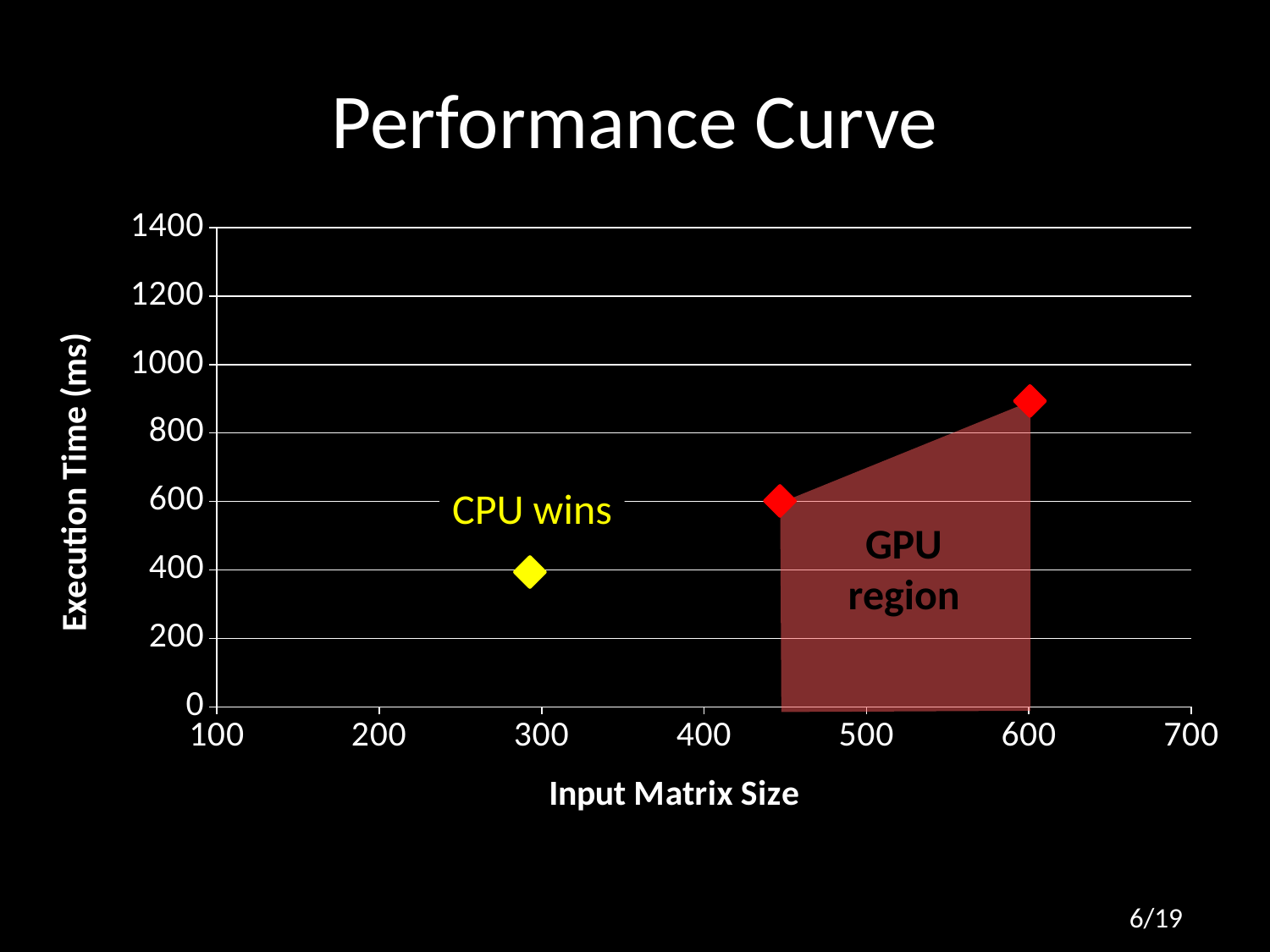
Is the execution time of the rightmost red point greater or less than 1000? less Which point has the highest execution time: the yellow point, the left red point, or the right red point? the right red point What is the title of the chart? Performance Curve Does execution time rise or fall as input matrix size increases along the x axis? rise How many data points are plotted on the chart? 3 Is the execution time of the yellow point larger or smaller than that of the left red point? smaller What is the label of the y axis? Execution Time (ms) Is the execution time of the yellow point greater or less than 200? greater Which point has the lowest execution time: the yellow point, the left red point, or the right red point? the yellow point Is the execution time of the rightmost red point greater or less than 800? greater What kind of chart is shown on the slide? scatter chart